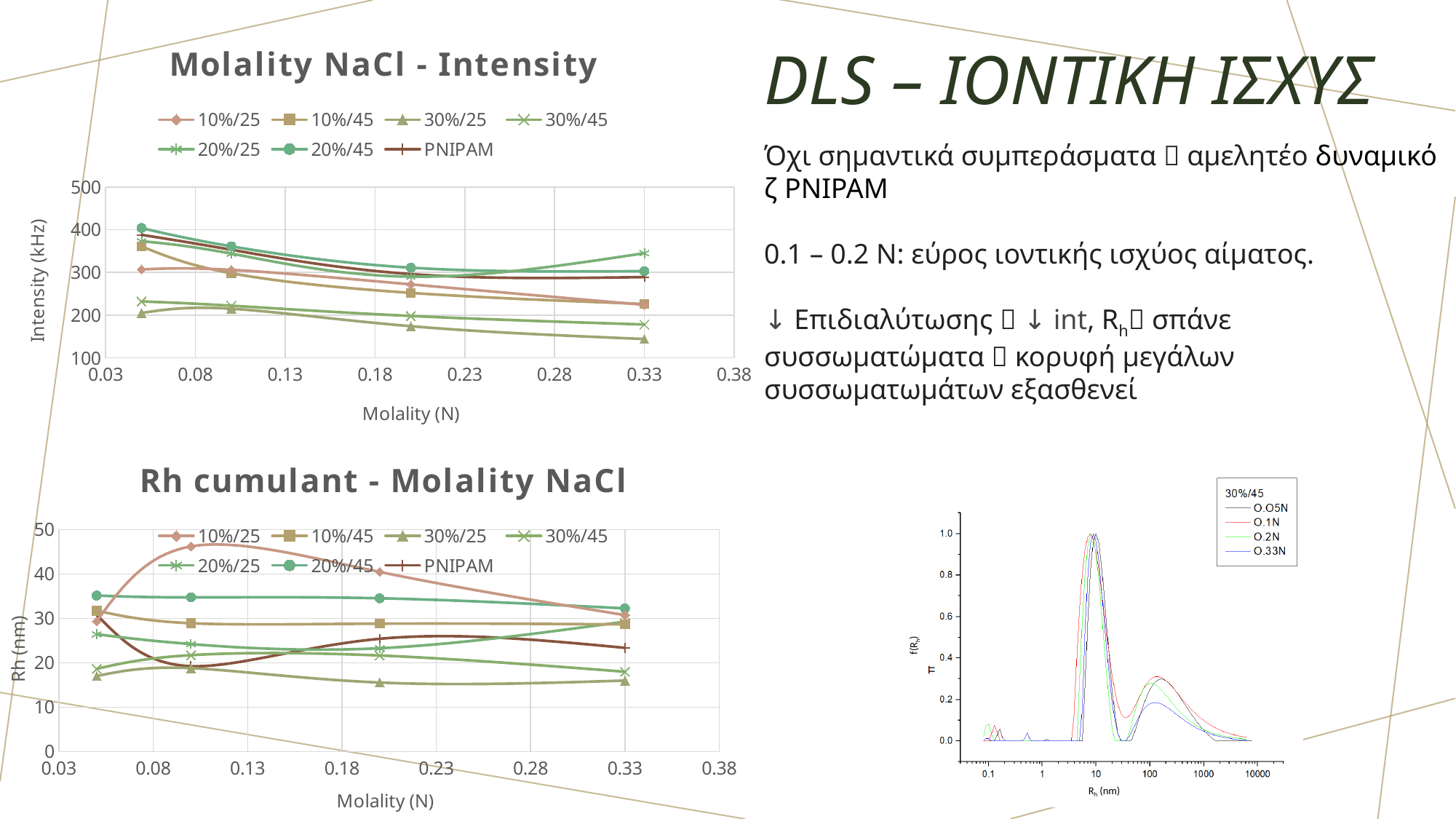
In the "Rh cumulant - Molality NaCl" chart, which series has the lowest Rh at about 0.2 N? 30%/25 In the "Molality NaCl - Intensity" chart, which series has the highest intensity at the lowest molality (about 0.05 N)? 20%/45 In the "Molality NaCl - Intensity" chart, how many data points does the 10%/45 series have? 4 In the "Rh cumulant - Molality NaCl" chart, is the Rh of 10%/25 at about 0.1 N greater or less than 40 nm? greater In the "Rh cumulant - Molality NaCl" chart, which series has the highest Rh at about 0.1 N? 10%/25 In the "Molality NaCl - Intensity" chart, does the intensity of the 10%/45 series rise or fall as molality increases? fall In the "Molality NaCl - Intensity" chart, is the intensity of 20%/25 at 0.33 N greater or less than 300 kHz? greater In the "Molality NaCl - Intensity" chart, at 0.33 N, which has the larger intensity: 20%/25 or 10%/25? 20%/25 In the "Molality NaCl - Intensity" chart, which series has the lowest intensity at 0.33 N? 30%/25 What kind of chart is the "Molality NaCl - Intensity" chart? line chart In the "Molality NaCl - Intensity" chart, is the intensity of 30%/25 at 0.33 N greater or less than 200 kHz? less How many series does the legend of the "Molality NaCl - Intensity" chart list? 7